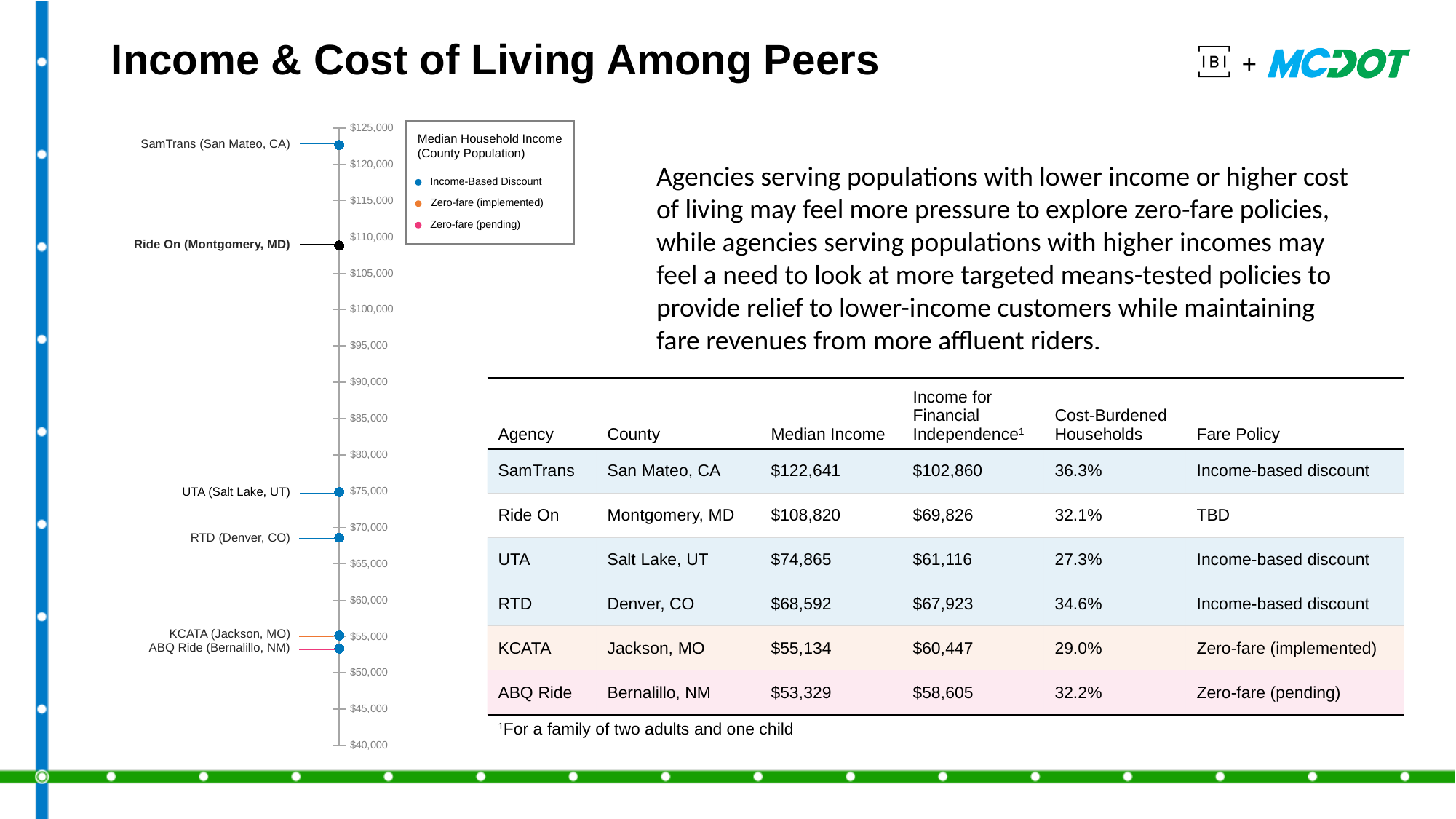
How many series does the chart legend list? 3 What kind of chart is the Median Household Income chart? Dot plot What is the difference between the median incomes of SamTrans and Ride On as shown on the slide? $13,821 How many agencies are plotted on the Median Household Income chart? 6 Is the median household income for Ride On (Montgomery, MD) greater or less than $105,000? greater Which agency has the lowest median household income on the chart? ABQ Ride (Bernalillo, NM) Is the median household income for RTD (Denver, CO) greater or less than $70,000? less What is the median income for Ride On (Montgomery, MD) as shown on the slide? $108,820 Which has the higher median household income, UTA (Salt Lake, UT) or RTD (Denver, CO)? UTA (Salt Lake, UT) What is the title of the chart on the left of the slide? Median Household Income (County Population) Is the median household income for SamTrans (San Mateo, CA) greater or less than $120,000? greater Which agency has the highest median household income on the chart? SamTrans (San Mateo, CA)